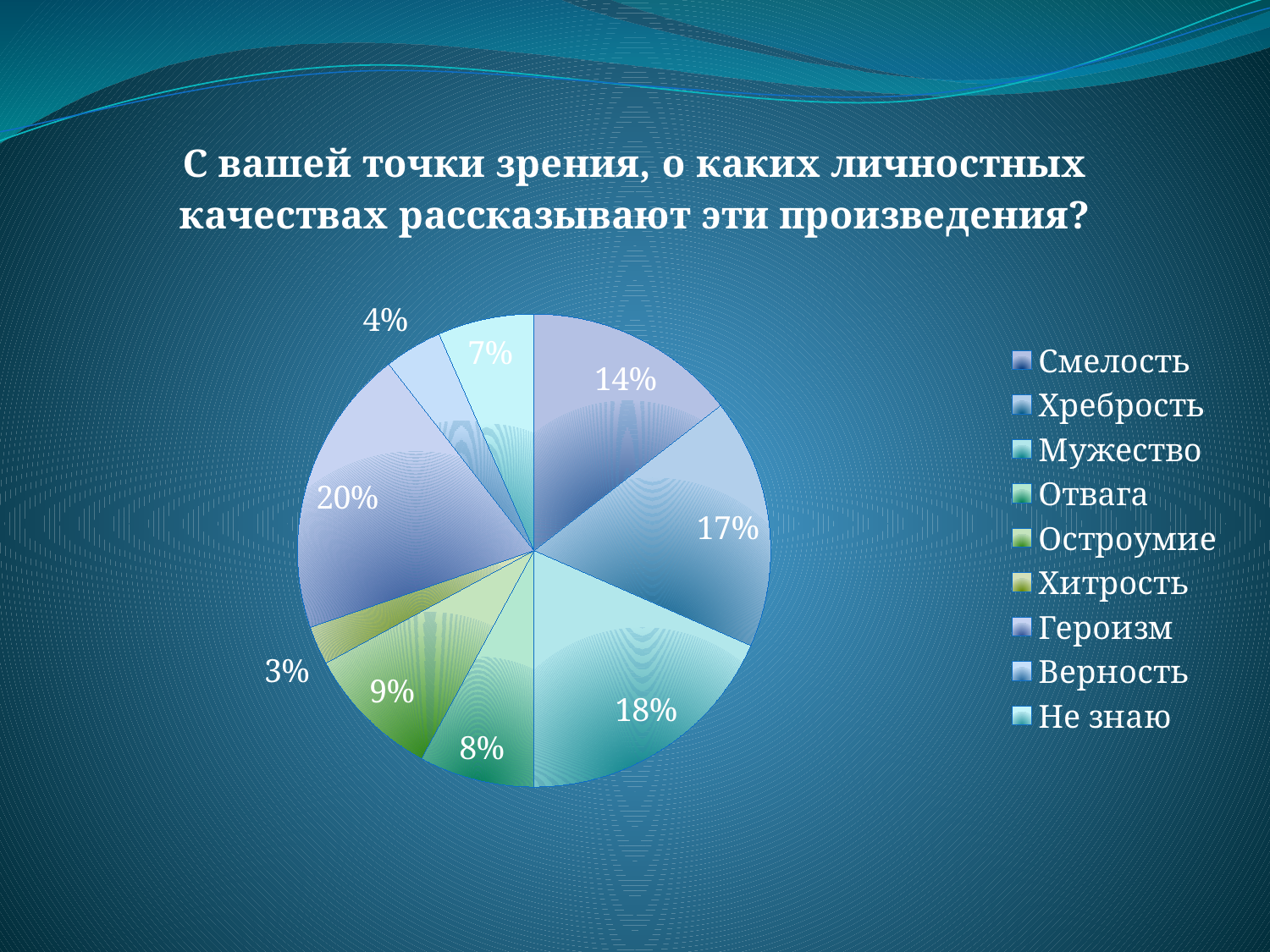
What percentage is shown for Мужество? 18% What is the title of the chart? С вашей точки зрения, о каких личностных качествах рассказывают эти произведения? How many categories does the pie chart have? 9 What percentage is shown for Не знаю? 7% What percentage is shown for Героизм? 20% Which category has the smallest share of the pie? Хитрость Which category has the largest share of the pie? Героизм What is the combined share of Отвага and Остроумие? 17% Which is larger, the share for Хребрость or the share for Смелость? Хребрость What type of chart is shown on the slide? pie chart What is the difference between the shares for Героизм and Смелость? 6% What percentage is shown for Хитрость? 3%